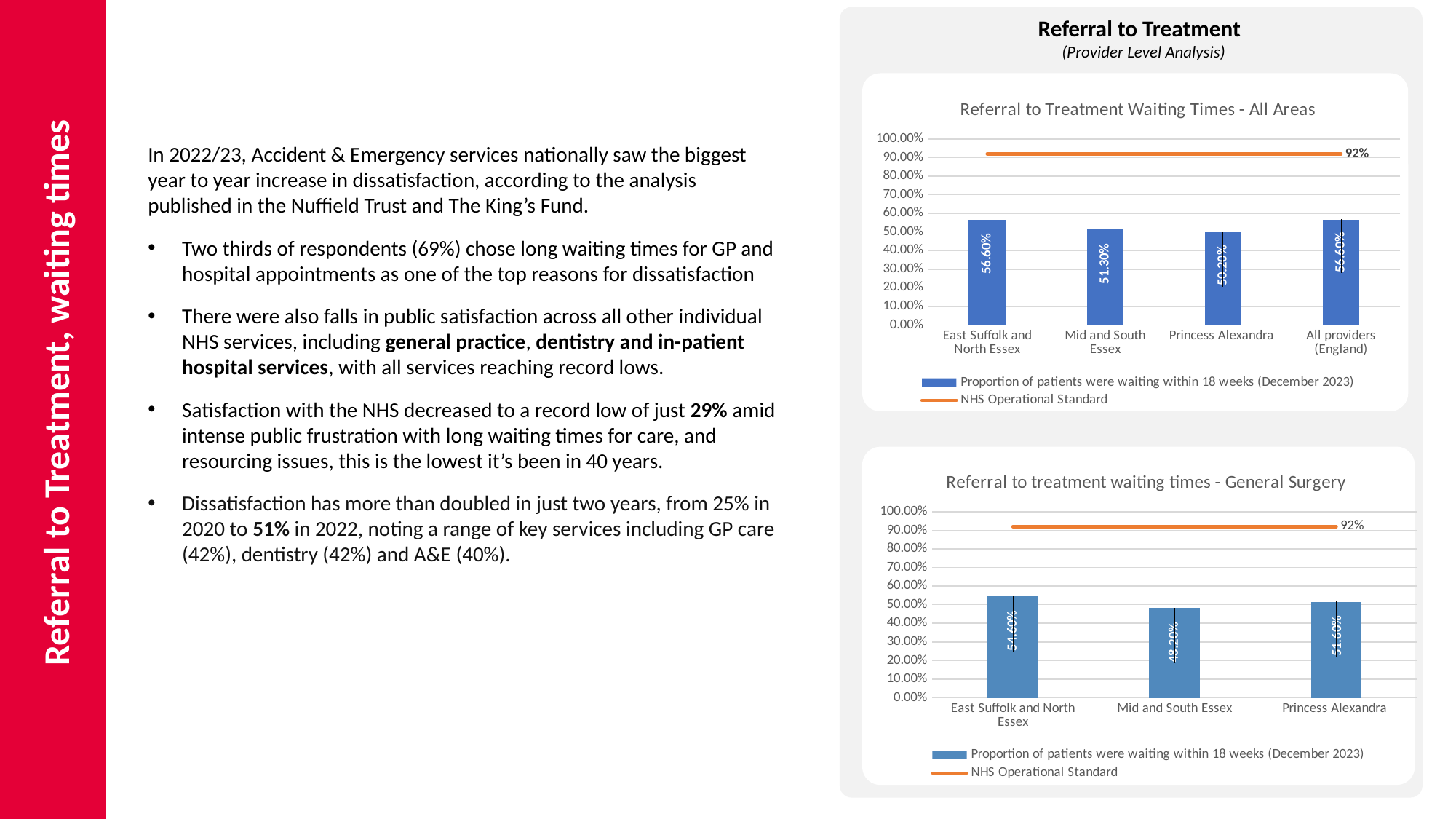
In the 'Referral to treatment waiting times - General Surgery' chart, what is the difference between East Suffolk and North Essex and Mid and South Essex? 6.40% In the 'Referral to treatment waiting times - General Surgery' chart, what is the value for Mid and South Essex? 48.20% In the 'Referral to Treatment Waiting Times - All Areas' chart, what is the value for Princess Alexandra? 50.20% In the 'Referral to treatment waiting times - General Surgery' chart, which provider has the lowest proportion of patients waiting within 18 weeks? Mid and South Essex In the 'Referral to Treatment Waiting Times - All Areas' chart, is the value for All providers (England) greater or less than 50.00%? greater How many provider categories are shown in the 'Referral to Treatment Waiting Times - All Areas' chart? 4 In the 'Referral to treatment waiting times - General Surgery' chart, is the value for Mid and South Essex greater or less than 50.00%? less In the 'Referral to Treatment Waiting Times - All Areas' chart, what is the value for Mid and South Essex? 51.30% How many series does the legend of the 'Referral to treatment waiting times - General Surgery' chart list? 2 In the 'Referral to Treatment Waiting Times - All Areas' chart, which is larger: Mid and South Essex or Princess Alexandra? Mid and South Essex What value does the NHS Operational Standard line show in the 'Referral to Treatment Waiting Times - All Areas' chart? 92% In the 'Referral to treatment waiting times - General Surgery' chart, which provider has the highest proportion of patients waiting within 18 weeks? East Suffolk and North Essex